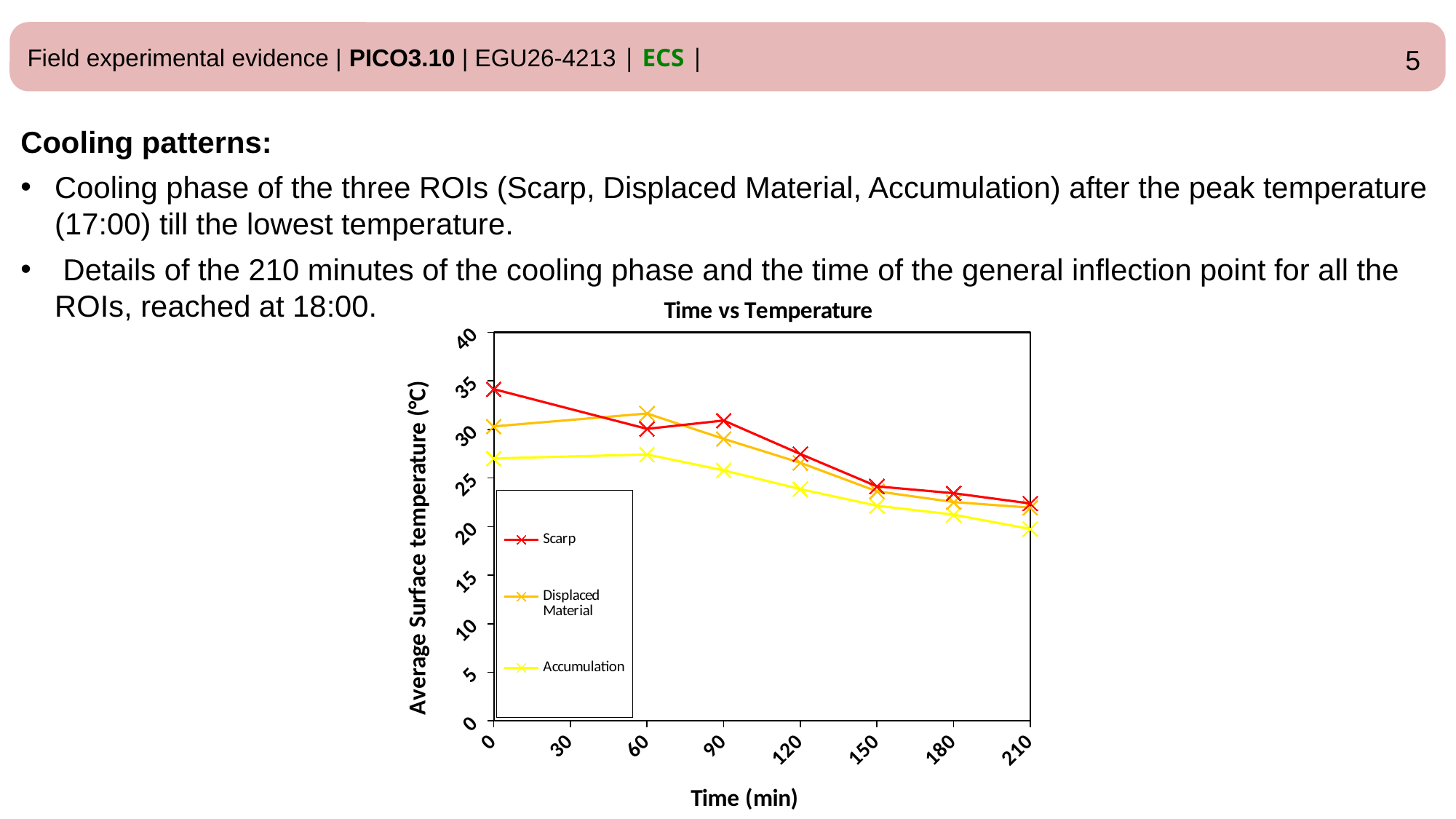
At 0 min, which is larger: the value for Scarp or the value for Accumulation? Scarp What type of chart is shown on the slide? line chart What is the label of the y axis of the chart? Average Surface temperature (°C) At 60 min, which is larger: the value for Displaced Material or the value for Scarp? Displaced Material Which series has the highest value at 0 min? Scarp Do the values for Scarp generally rise or fall as time increases from 0 to 210 min? fall Which series has the lowest value at 210 min? Accumulation What is the title of the chart? Time vs Temperature Is the value for Displaced Material at 120 min greater or less than 30? less How many series does the legend of the chart list? 3 Is the value for Accumulation at 0 min greater or less than 25? greater Is the value for Scarp at 0 min greater or less than 30? greater